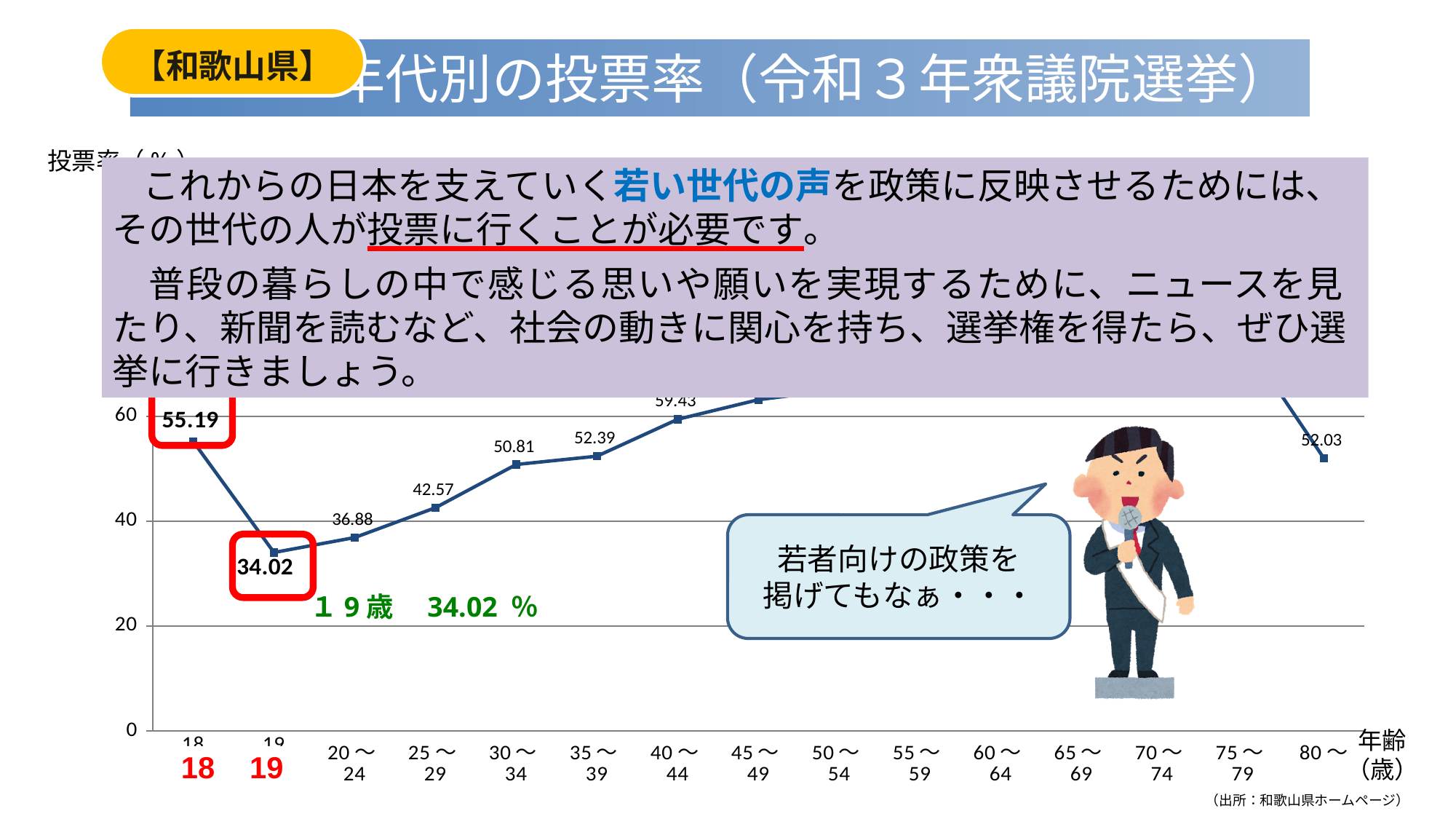
Is the value for the 19 age category greater or less than 40? less What kind of chart is used on this slide? line chart What value is shown for the 25～29 age group? 42.57 Which age category has the lowest voter turnout on the chart? 19 What is the voter turnout value plotted for the 19 age category? 34.02 What value is shown for the 40～44 age group? 59.43 What value is shown for the 80～ age group? 52.03 What is the difference between the turnout for age 18 and age 19? 21.17 What value is shown for the 20～24 age group? 36.88 Which has the higher turnout, the 18 age category or the 20～24 age group? 18 Do the values rise or fall along the x axis from the 19 category to the 40～44 group? rise What is the voter turnout value plotted for the 18 age category? 55.19